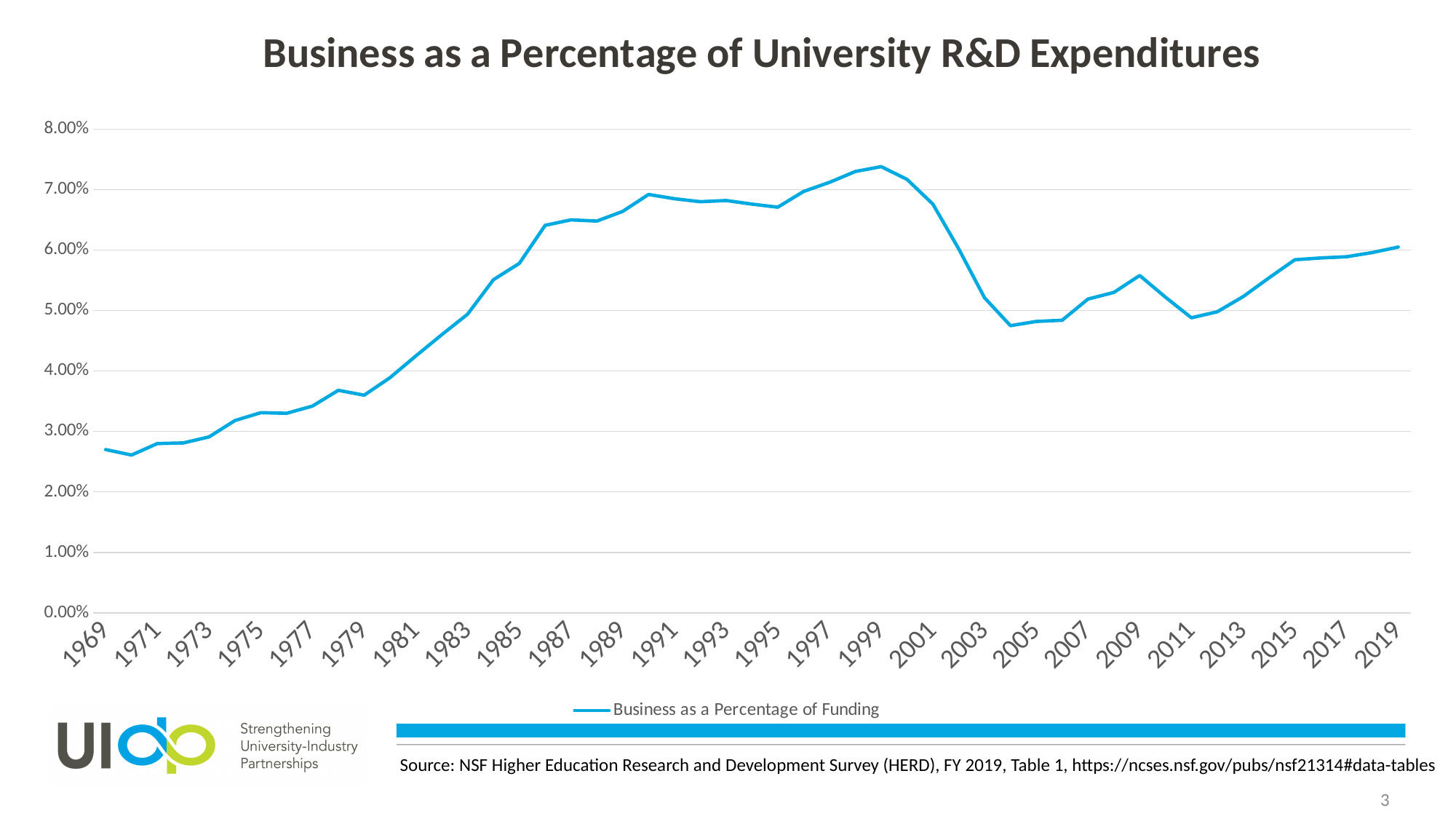
What kind of chart is shown on the slide? line chart Does the line generally rise or fall between 1999 and 2005? fall How many series does the legend list? 1 Which year has the larger value, 1999 or 2005? 1999 Is the value for 1999 greater or less than 7.00%? greater What is the legend entry for the plotted line? Business as a Percentage of Funding Is the value for 1969 greater or less than 3.00%? less Is the value for 1979 greater or less than 4.00%? less Which year has the larger value, 1969 or 2019? 2019 In which year does the line reach its highest value? 1999